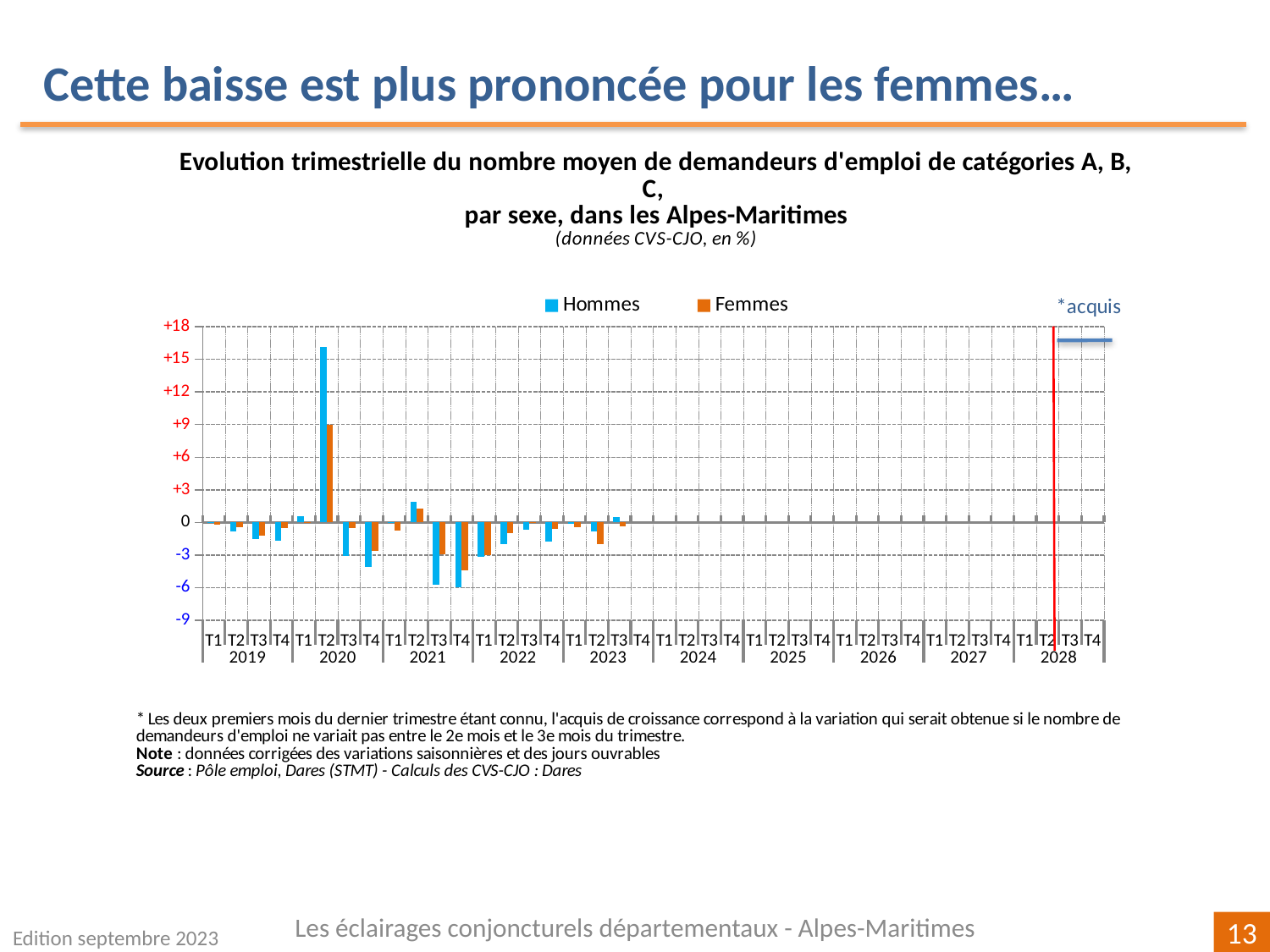
Which series is shown in orange? Femmes What are the two series named in the legend? Hommes and Femmes Is the Femmes value for T2 2020 greater or less than +6? greater How many years are labelled along the x axis? 10 In T2 2020, which series has the larger value, Hommes or Femmes? Hommes What kind of chart is shown on the slide? bar chart Is the Hommes value for T2 2020 greater or less than +15? greater In which quarter does the Hommes series reach its highest value? T2 2020 Is the Femmes value for T4 2021 greater or less than -3? less How many series does the legend list? 2 In which quarter does the Femmes series reach its highest value? T2 2020